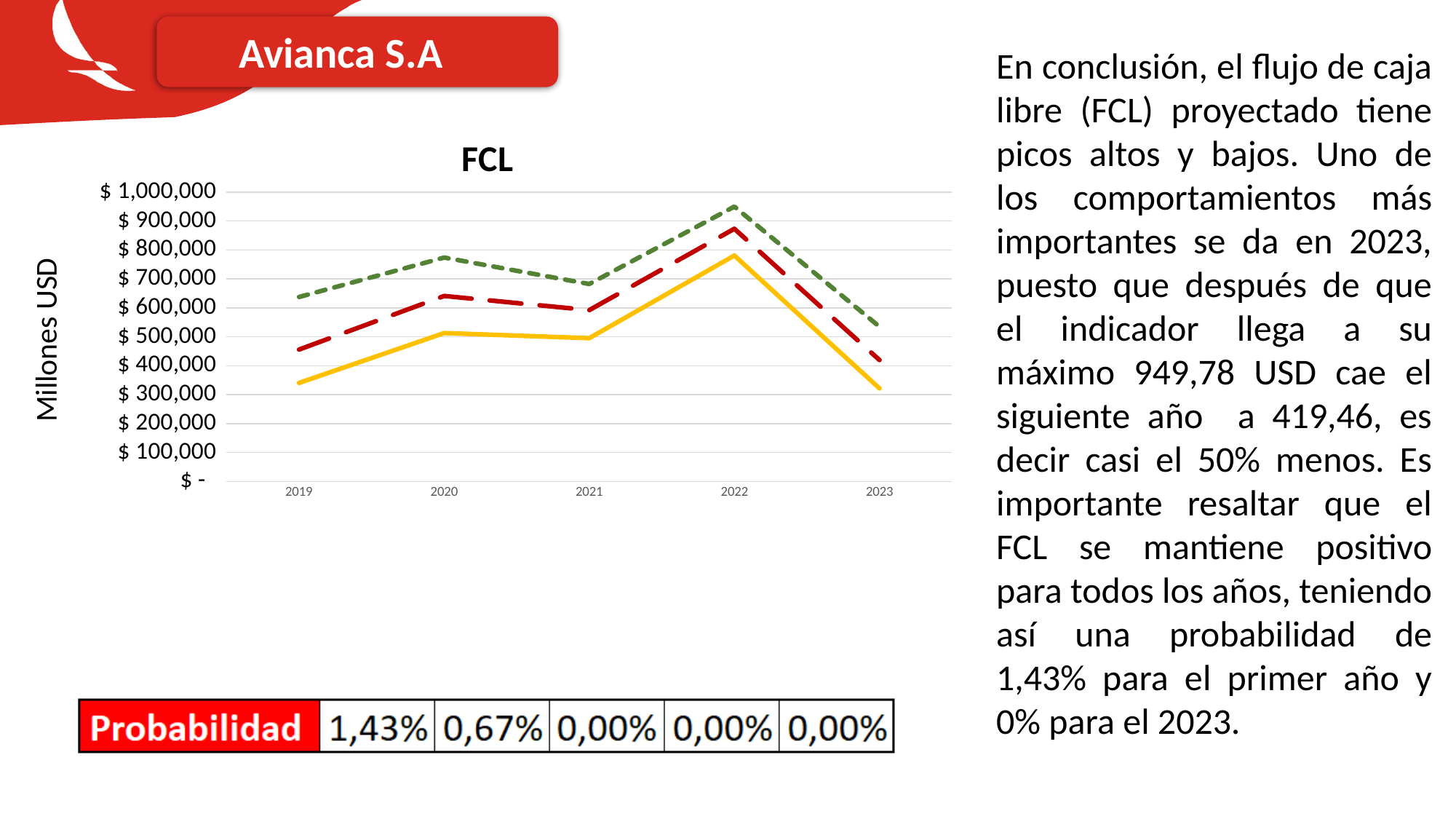
What kind of chart is shown on the slide? line chart What is the title of the chart? FCL How many years are plotted along the x axis of the chart? 5 In which year does the green dotted line reach its highest value? 2022 Is the value of the red dashed line in 2019 greater or less than $ 500,000? less What is the label on the vertical axis of the chart? Millones USD Is the value of the solid yellow line in 2022 greater or less than $ 700,000? greater In which year does the solid yellow line reach its highest value? 2022 Is the value of the green dotted line in 2023 greater or less than $ 500,000? greater Do the lines rise or fall from 2022 to 2023? fall In 2021, which line has the higher value, the green dotted line or the solid yellow line? green dotted line